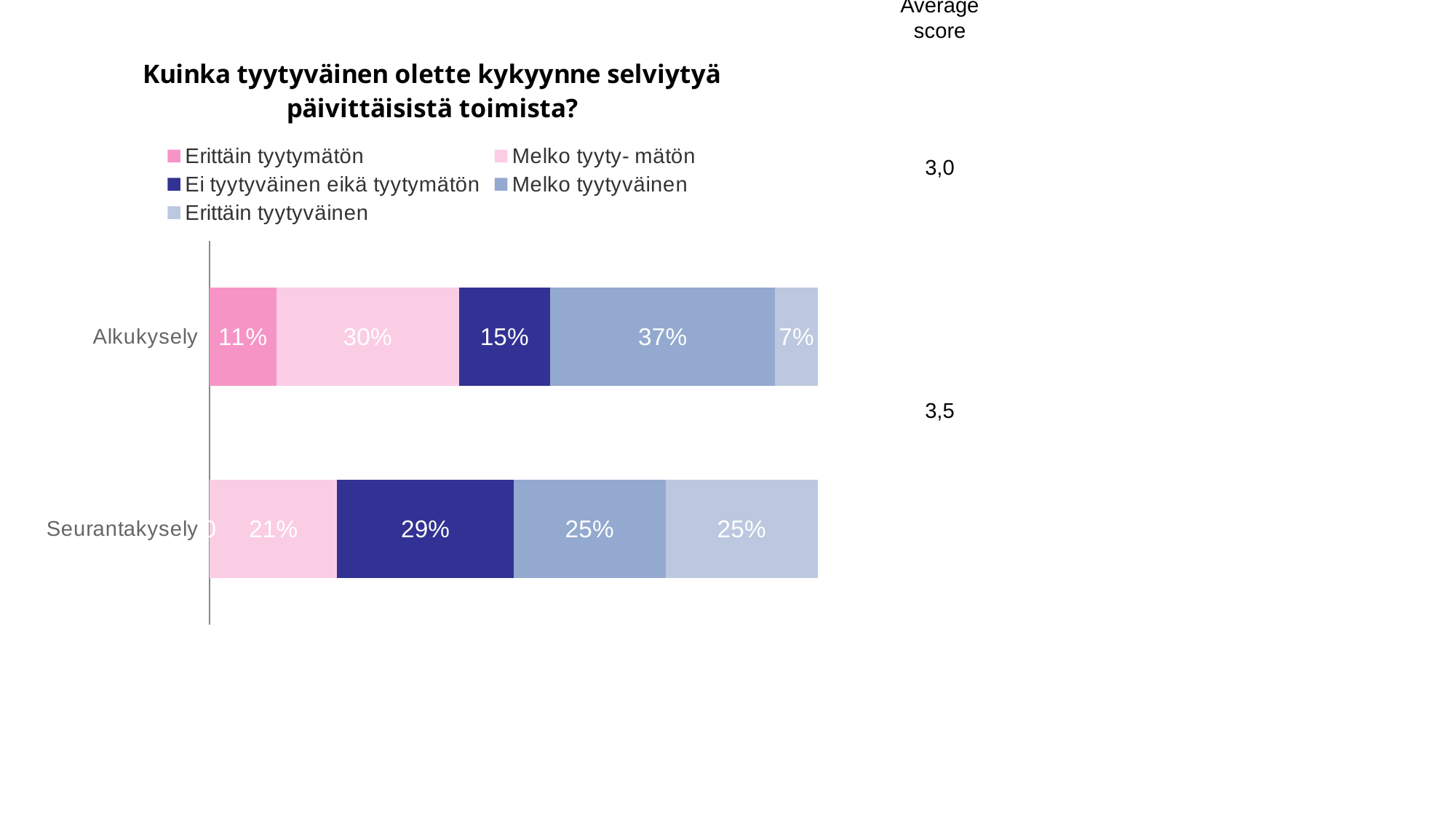
What is the value for Melko tyytyväinen in the Alkukysely bar? 37% What is the title of the chart? Kuinka tyytyväinen olette kykyynne selviytyä päivittäisistä toimista? Which is larger: Melko tyytymätön in Alkukysely or Melko tyytymätön in Seurantakysely? Alkukysely What is the value for Erittäin tyytyväinen in the Seurantakysely bar? 25% How many categories (survey rounds) are plotted on the chart? 2 What kind of chart is shown on the slide? stacked bar chart What is the value for Erittäin tyytymätön in the Alkukysely bar? 11% Which segment is the smallest in the Alkukysely bar? Erittäin tyytyväinen How many series does the legend list? 5 Which segment is the largest in the Alkukysely bar? Melko tyytyväinen What is the difference between the Erittäin tyytyväinen values for Seurantakysely and Alkukysely? 18% What is the value for Ei tyytyväinen eikä tyytymätön in the Seurantakysely bar? 29%